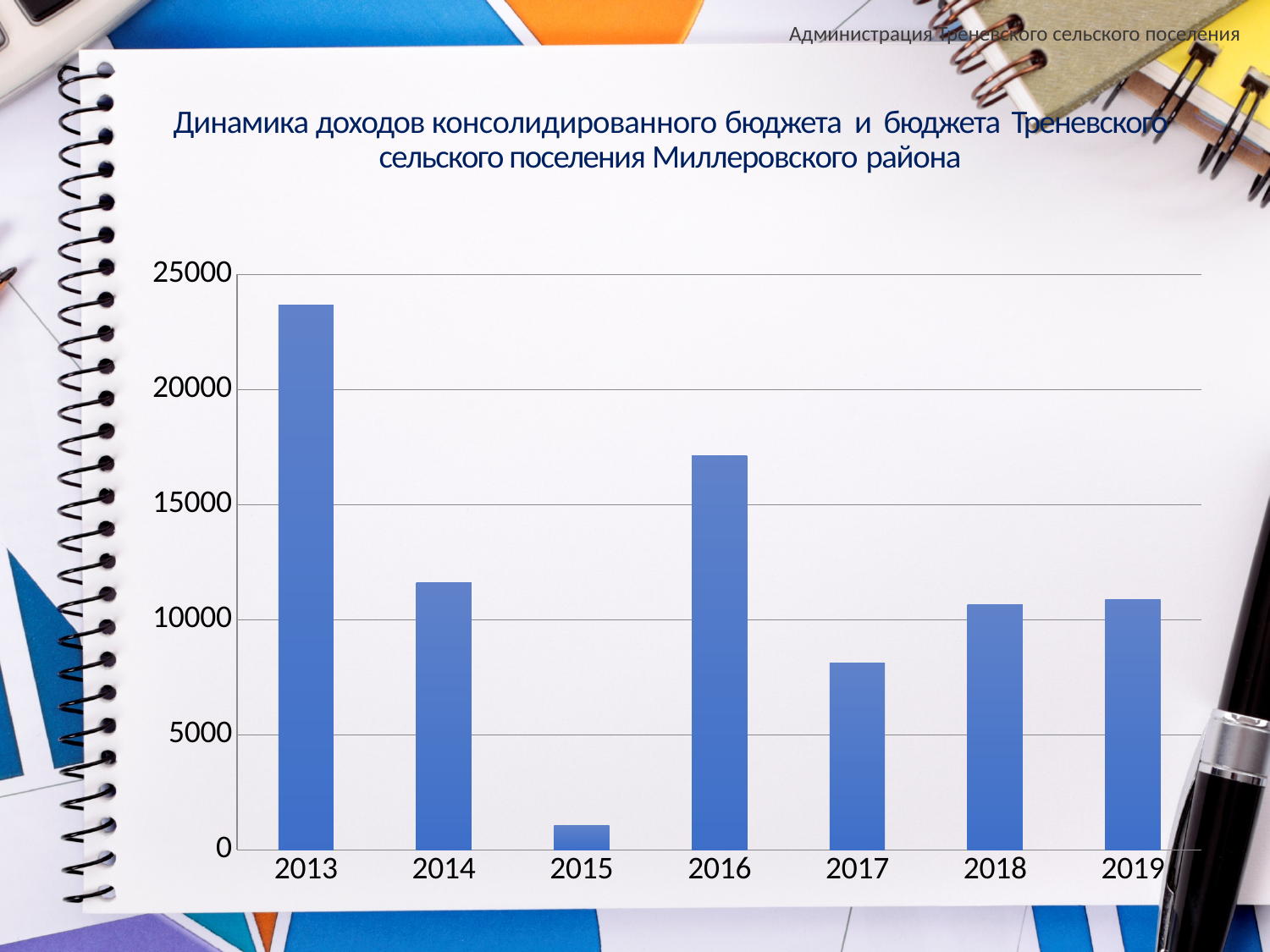
Is the value for 2015 greater or less than 5000? less Do the values rise or fall from 2013 to 2015? fall Which year has the highest value in the chart? 2013 What kind of chart is shown on the slide? bar chart How many years are shown on the x axis of the chart? 7 What is the title of the chart on the slide? Динамика доходов консолидированного бюджета и бюджета Треневского сельского поселения Миллеровского района Which year has the larger value, 2014 or 2017? 2014 Which year has the lowest value in the chart? 2015 Is the value for 2013 greater or less than 20000? greater Is the value for 2017 greater or less than 10000? less Which year has the larger value, 2013 or 2016? 2013